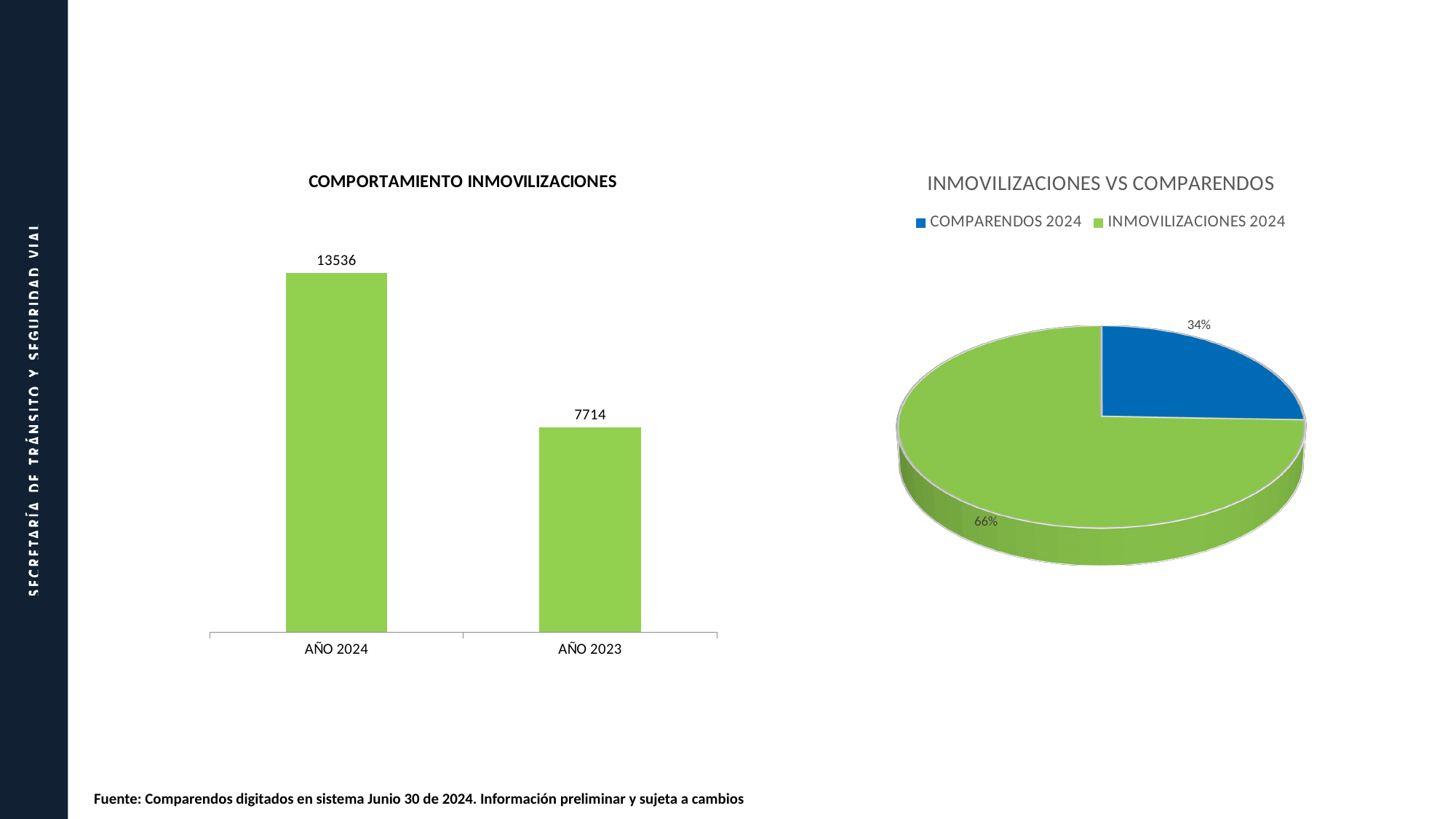
In the 'COMPORTAMIENTO INMOVILIZACIONES' chart, what is the value for AÑO 2023? 7714 In the 'COMPORTAMIENTO INMOVILIZACIONES' chart, which is larger, AÑO 2024 or AÑO 2023? AÑO 2024 In the 'COMPORTAMIENTO INMOVILIZACIONES' chart, how many categories are shown? 2 In the 'COMPORTAMIENTO INMOVILIZACIONES' chart, what is the value for AÑO 2024? 13536 In the 'COMPORTAMIENTO INMOVILIZACIONES' chart, which category has the highest value? AÑO 2024 In the 'INMOVILIZACIONES VS COMPARENDOS' chart, how many entries does the legend list? 2 In the 'INMOVILIZACIONES VS COMPARENDOS' chart, what share does COMPARENDOS 2024 have? 34% What kind of chart is 'INMOVILIZACIONES VS COMPARENDOS'? Pie chart What kind of chart is 'COMPORTAMIENTO INMOVILIZACIONES'? Bar chart In the 'COMPORTAMIENTO INMOVILIZACIONES' chart, which category has the lowest value? AÑO 2023 In the 'COMPORTAMIENTO INMOVILIZACIONES' chart, what is the difference between the values for AÑO 2024 and AÑO 2023? 5822 In the 'INMOVILIZACIONES VS COMPARENDOS' chart, what share does INMOVILIZACIONES 2024 have? 66%